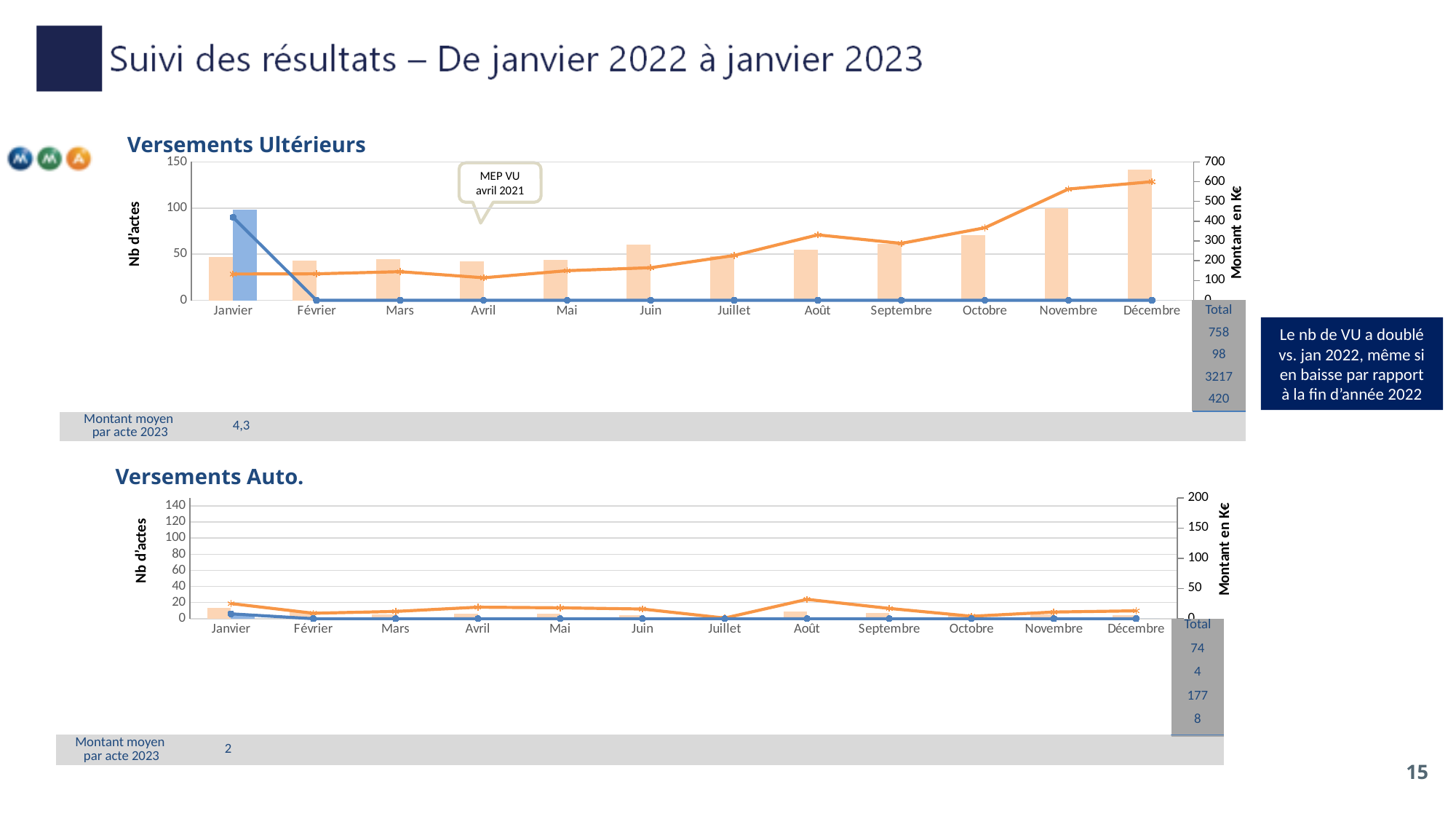
In the 'Versements Ultérieurs' chart, which month has the tallest orange bar? Décembre In the 'Versements Ultérieurs' chart, is the orange line value for Décembre greater or less than 500 on the right axis? greater In the 'Versements Ultérieurs' chart, is the orange bar for Décembre greater or less than 100 on the left axis? greater In the 'Versements Auto.' chart, which month has the highest point on the orange line? Août What is the title of the right-hand axis of the 'Versements Ultérieurs' chart? Montant en K€ How many months are shown on the x axis of the 'Versements Ultérieurs' chart? 12 In the 'Versements Ultérieurs' chart, does the orange line rise or fall from Janvier to Décembre? rise In the 'Versements Auto.' chart, is the orange bar for Janvier greater or less than 20 on the left axis? less What kind of chart is the 'Versements Ultérieurs' chart? Combined bar and line chart In the 'Versements Ultérieurs' chart, which orange bar is taller, Janvier or Décembre? Décembre In the 'Versements Auto.' chart, which month has the tallest orange bar? Janvier